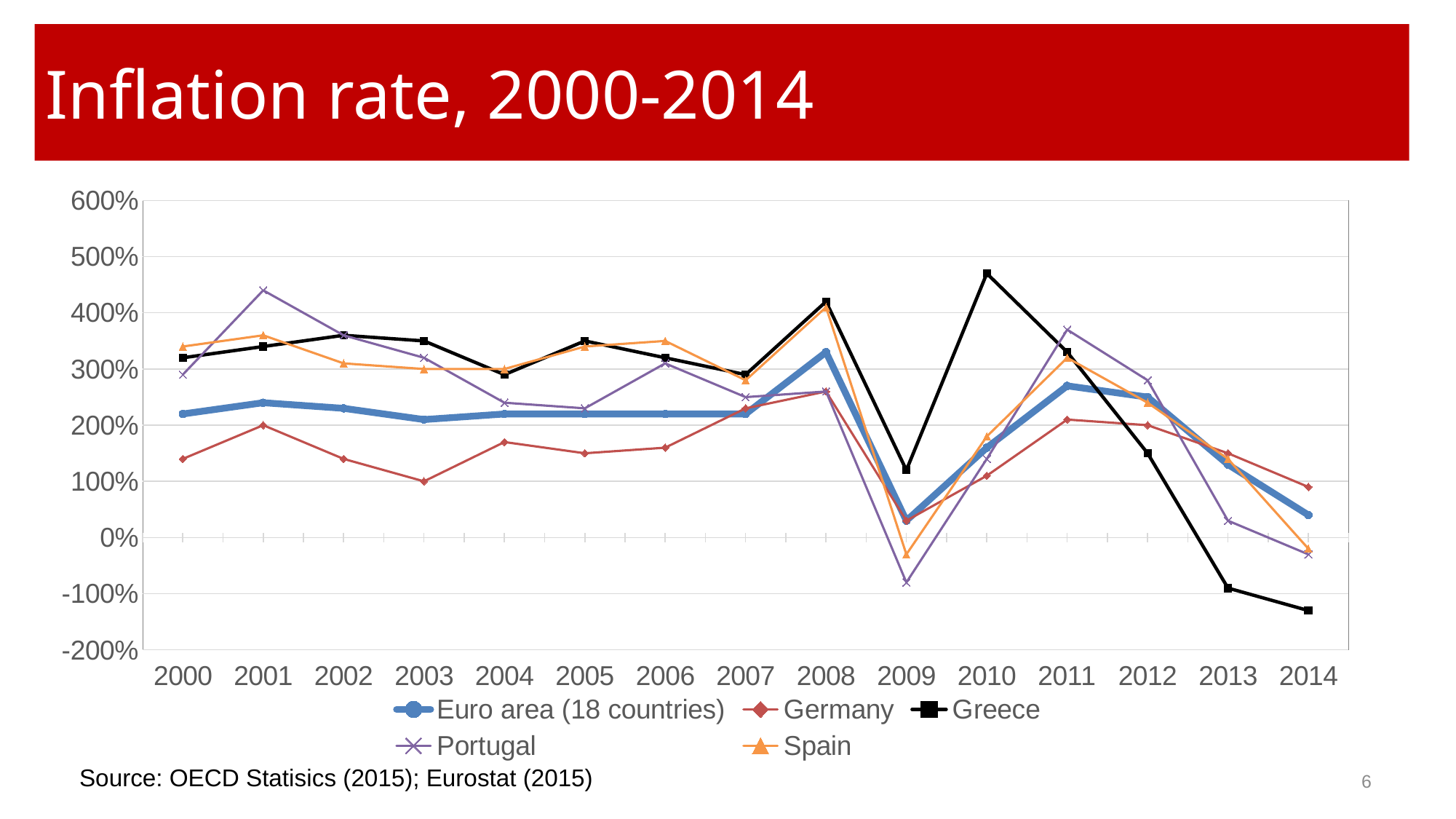
Which series has the lowest value in 2014? Greece Does the Greece line rise or fall from 2012 to 2014? fall How many years are shown along the x axis? 15 In 2008, which is larger: the value for Greece or the value for Germany? Greece How many series does the legend list? 5 Is the value for Euro area (18 countries) in 2008 greater or less than 300%? greater Is the value for Portugal in 2009 greater or less than 0%? less What kind of chart is shown on the slide? line chart Is the value for Greece in 2014 greater or less than -100%? less Which series has the highest value in 2010? Greece Which series has the highest value in 2001? Portugal